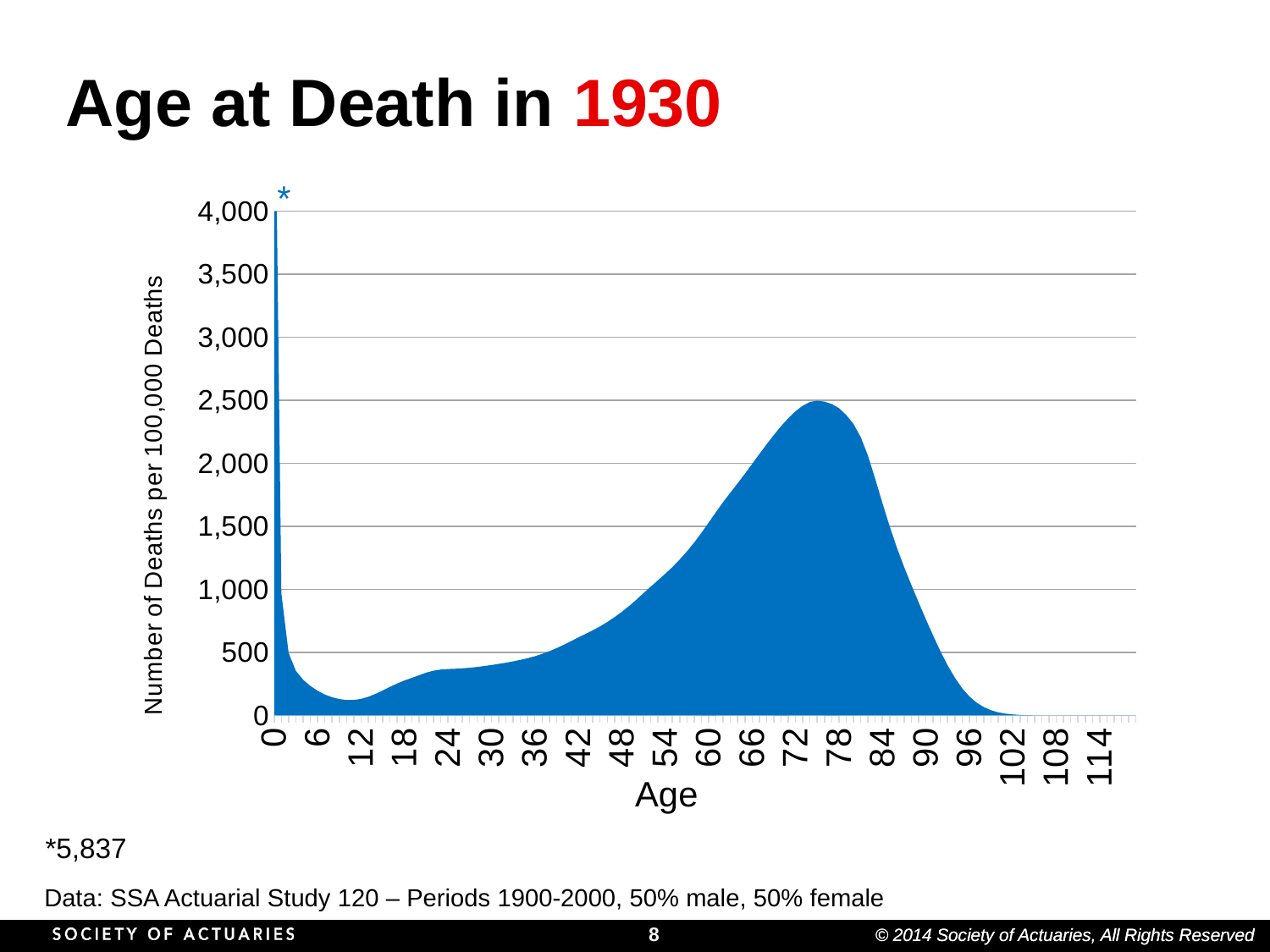
What is the title of the chart? Age at Death in 1930 Do the values rise or fall as age increases from 36 to 72? rise Which is larger, the value at age 72 or the value at age 24? age 72 What value does the asterisk at age 0 represent, according to the footnote? 5,837 What is the label of the vertical axis? Number of Deaths per 100,000 Deaths Is the value for age 48 greater or less than 500? greater Is the value for age 72 greater or less than 2,000? greater Is the value for age 60 greater or less than 1,000? greater What kind of chart is shown on the slide? area chart Do the values rise or fall as age increases from 78 to 96? fall